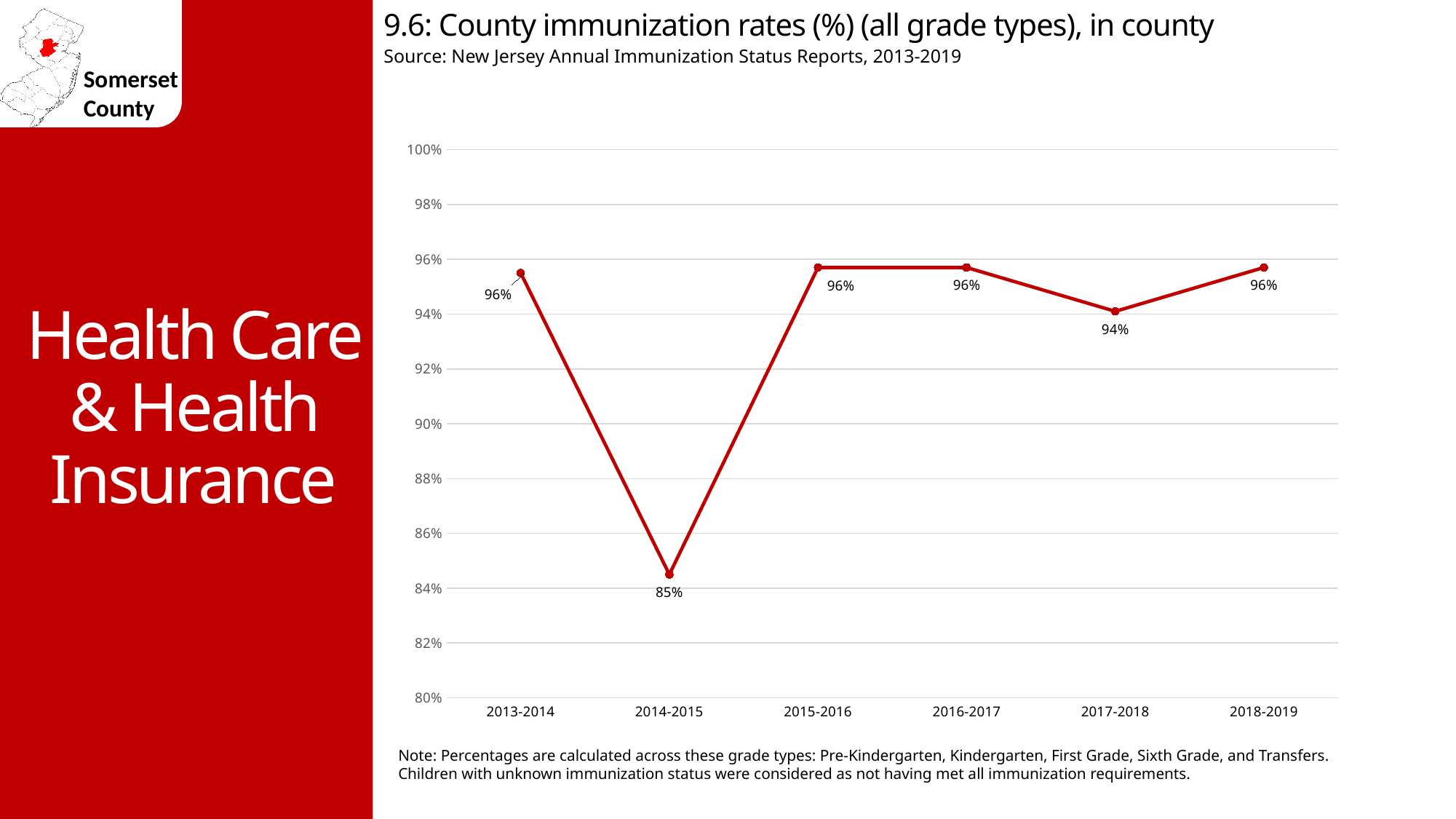
Which school year has the lowest immunization rate? 2014-2015 What is the county immunization rate for 2017-2018? 94% What is the county immunization rate for 2018-2019? 96% Which is larger, the immunization rate in 2014-2015 or in 2017-2018? 2017-2018 Does the immunization rate rise or fall from 2014-2015 to 2015-2016? rise What is the county immunization rate for 2013-2014? 96% What is the difference between the immunization rate in 2013-2014 and in 2014-2015? 11 percentage points What is the county immunization rate for 2014-2015? 85% What kind of chart is shown on the slide? line chart Is the immunization rate for 2014-2015 greater or less than 90%? less How many school years are plotted on the chart? 6 What is the difference between the immunization rate in 2018-2019 and in 2017-2018? 2 percentage points